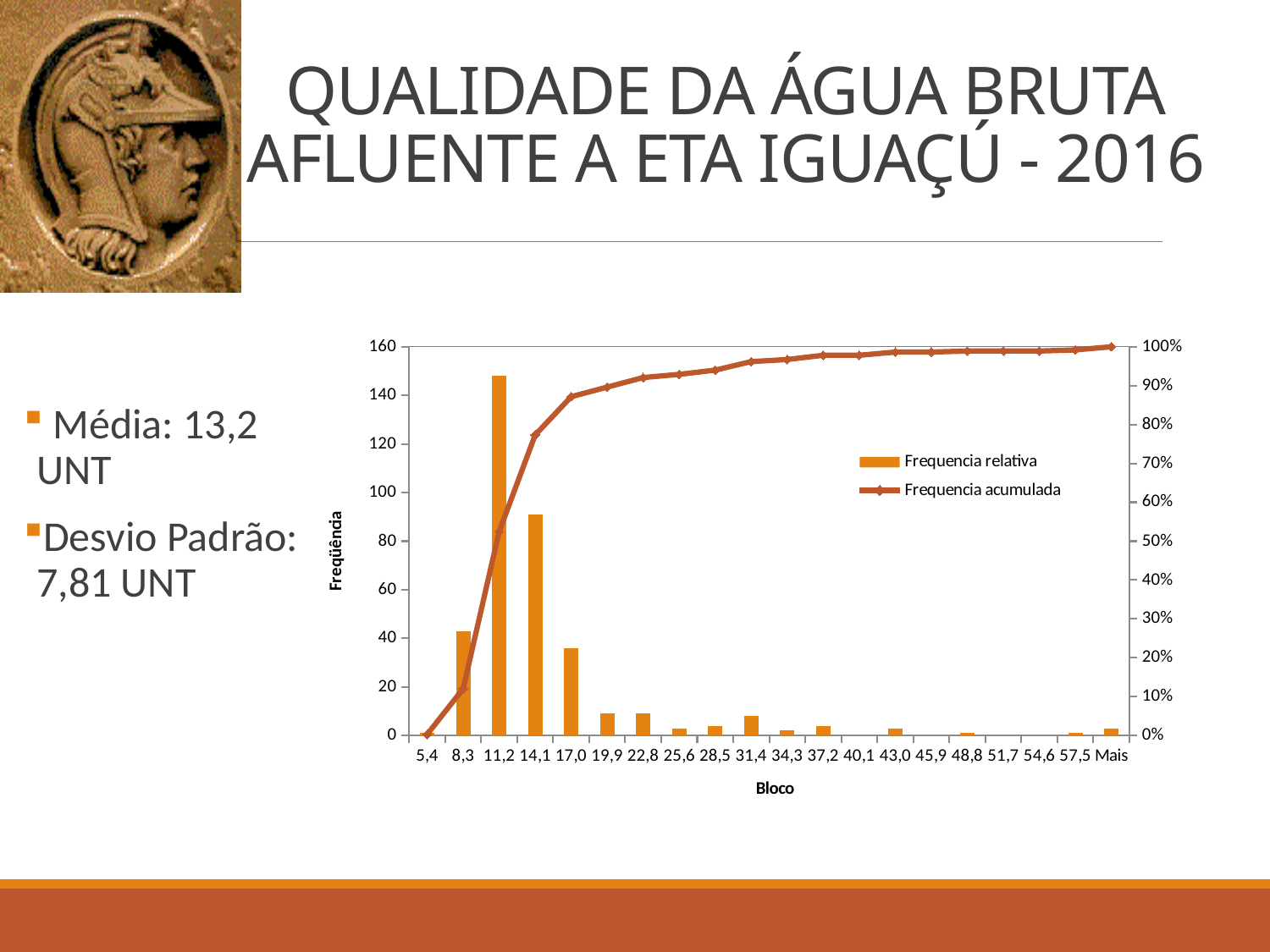
Which bloco has the highest Frequencia relativa bar? 11,2 Is the Frequencia acumulada value at bloco 14,1 greater or less than 70%? greater Is the Frequencia relativa value for bloco 14,1 greater or less than 80? greater How many categories (blocos) are shown along the x axis of the chart? 20 Is the Frequencia acumulada value at bloco 8,3 greater or less than 20%? less What kind of chart is shown on the slide? A bar chart combined with a line chart What are the two series named in the chart legend? Frequencia relativa and Frequencia acumulada How many series does the chart legend list? 2 Which bloco has the larger Frequencia relativa bar, 11,2 or 14,1? 11,2 Does the Frequencia acumulada line rise or fall as the blocos increase along the x axis? rise